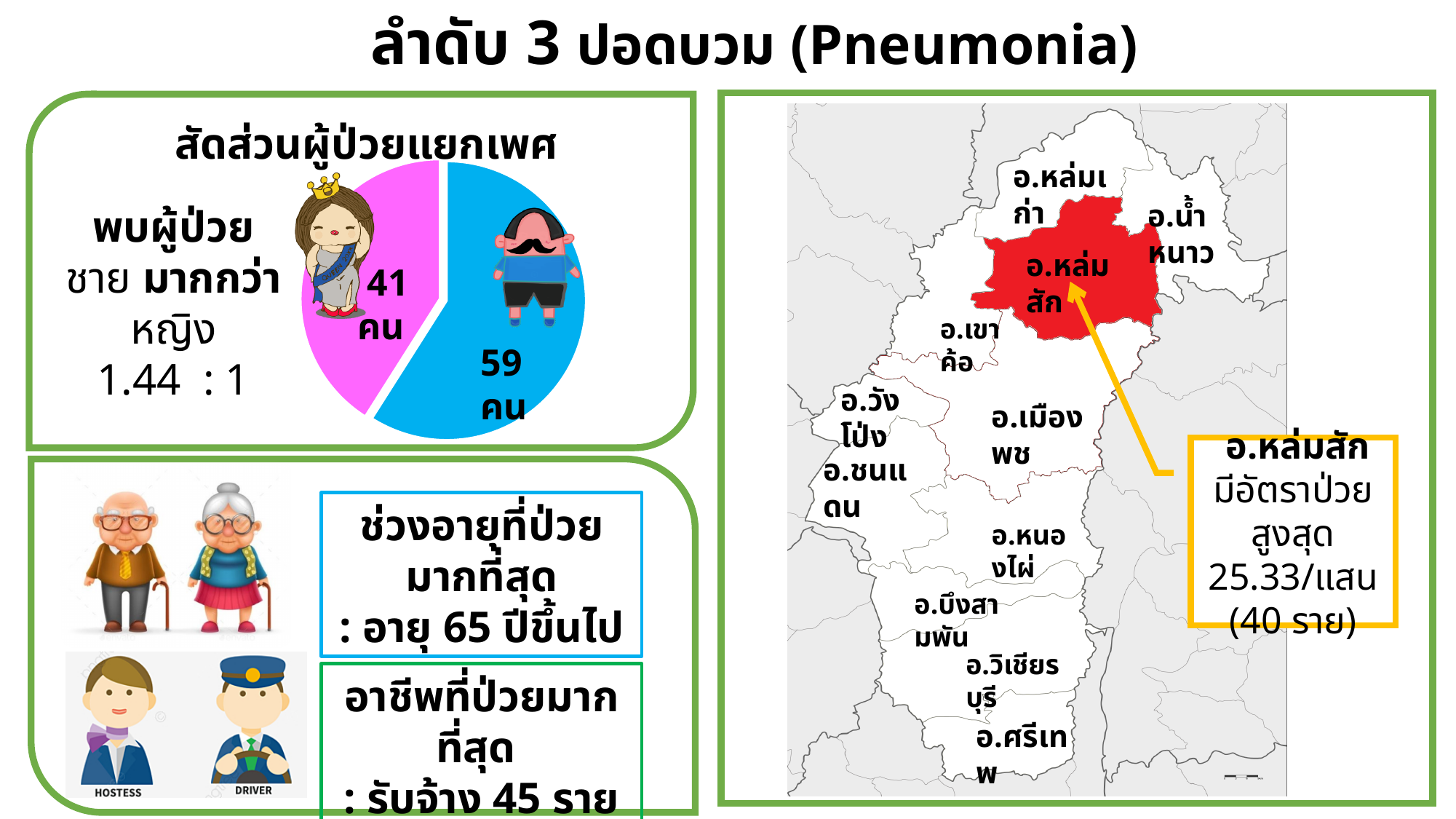
In the pie chart 'สัดส่วนผู้ป่วยแยกเพศ', how many patients does the blue (male) slice represent? 59 คน What is the male-to-female ratio stated next to the pie chart 'สัดส่วนผู้ป่วยแยกเพศ'? 1.44 : 1 In the pie chart 'สัดส่วนผู้ป่วยแยกเพศ', what share of the pie does the female (41 คน) slice represent? 41% In the pie chart 'สัดส่วนผู้ป่วยแยกเพศ', what is the total number of patients across both slices? 100 คน In the pie chart 'สัดส่วนผู้ป่วยแยกเพศ', what is the difference between the male and female patient counts? 18 คน In the pie chart 'สัดส่วนผู้ป่วยแยกเพศ', how many patients does the pink (female) slice represent? 41 คน In the pie chart 'สัดส่วนผู้ป่วยแยกเพศ', which gender has the smallest number of patients? female (หญิง) In the pie chart 'สัดส่วนผู้ป่วยแยกเพศ', which slice is larger, the male (blue) slice or the female (pink) slice? male (blue) How many slices does the pie chart 'สัดส่วนผู้ป่วยแยกเพศ' have? 2 In the pie chart 'สัดส่วนผู้ป่วยแยกเพศ', what share of the pie does the male (59 คน) slice represent? 59% In the pie chart 'สัดส่วนผู้ป่วยแยกเพศ', which gender has the largest number of patients? male (ชาย) What kind of chart is shown in the 'สัดส่วนผู้ป่วยแยกเพศ' panel? pie chart